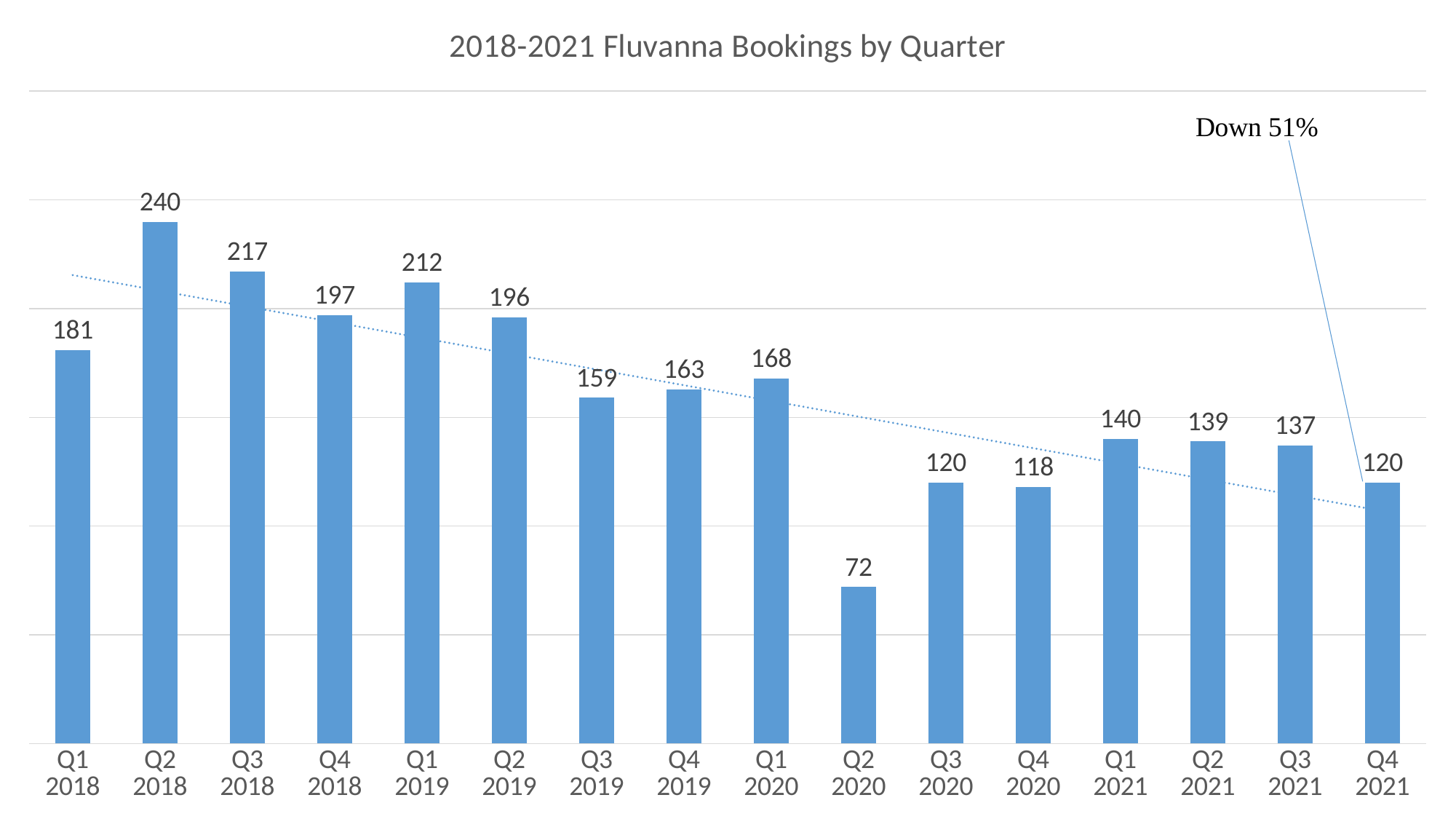
Which is larger, the value for Q3 2018 or the value for Q1 2019? Q3 2018 What is the difference between the bookings in Q1 2020 and Q2 2020? 96 What is the title of the chart? 2018-2021 Fluvanna Bookings by Quarter What is the value for Q1 2021? 140 What is the value for Q2 2018? 240 Which quarter has the highest number of bookings? Q2 2018 Do the bookings generally rise or fall from Q1 2018 to Q4 2021? Fall Which quarter has the lowest number of bookings? Q2 2020 What is the difference between the bookings in Q2 2018 and Q4 2021? 120 What is the value for Q2 2020? 72 What kind of chart is this? Bar chart How many quarters are shown on the x axis? 16